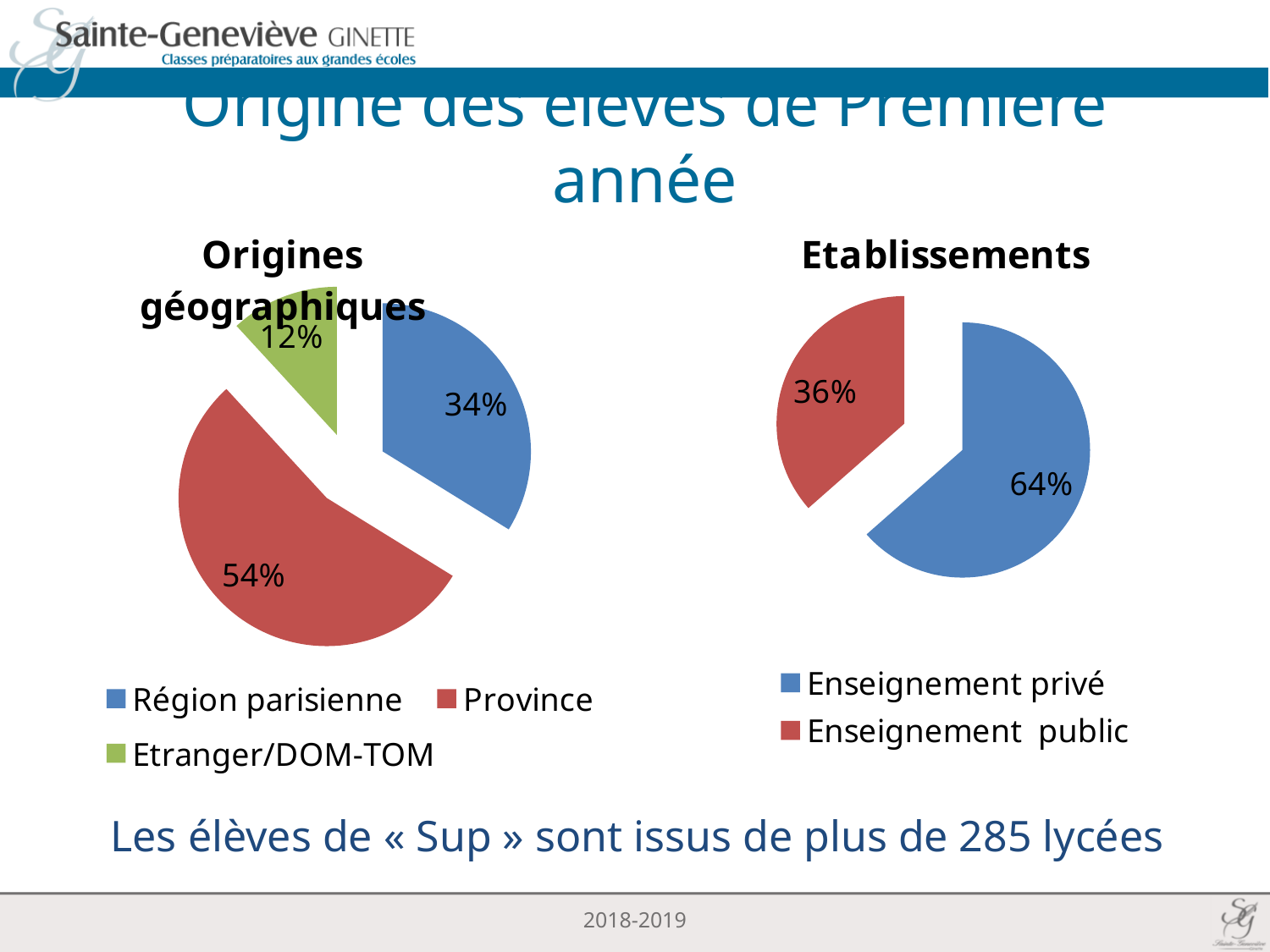
In the 'Origines géographiques' chart, which category has the largest share? Province In the 'Origines géographiques' chart, what is the difference between the Province and Région parisienne shares? 20% How many categories does the 'Origines géographiques' chart show? 3 In the 'Origines géographiques' chart, what percentage of students come from Région parisienne? 34% In the 'Origines géographiques' chart, what percentage of students come from Province? 54% In the 'Origines géographiques' chart, which category has the smallest share? Etranger/DOM-TOM In the 'Etablissements' chart, what percentage of students come from Enseignement public? 36% In the 'Etablissements' chart, which is larger: Enseignement privé or Enseignement public? Enseignement privé In the 'Etablissements' chart, what is the difference between the Enseignement privé and Enseignement public shares? 28% What type of chart is the 'Etablissements' chart? Pie chart In the 'Etablissements' chart, what percentage of students come from Enseignement privé? 64% In the 'Origines géographiques' chart, what percentage of students come from Etranger/DOM-TOM? 12%